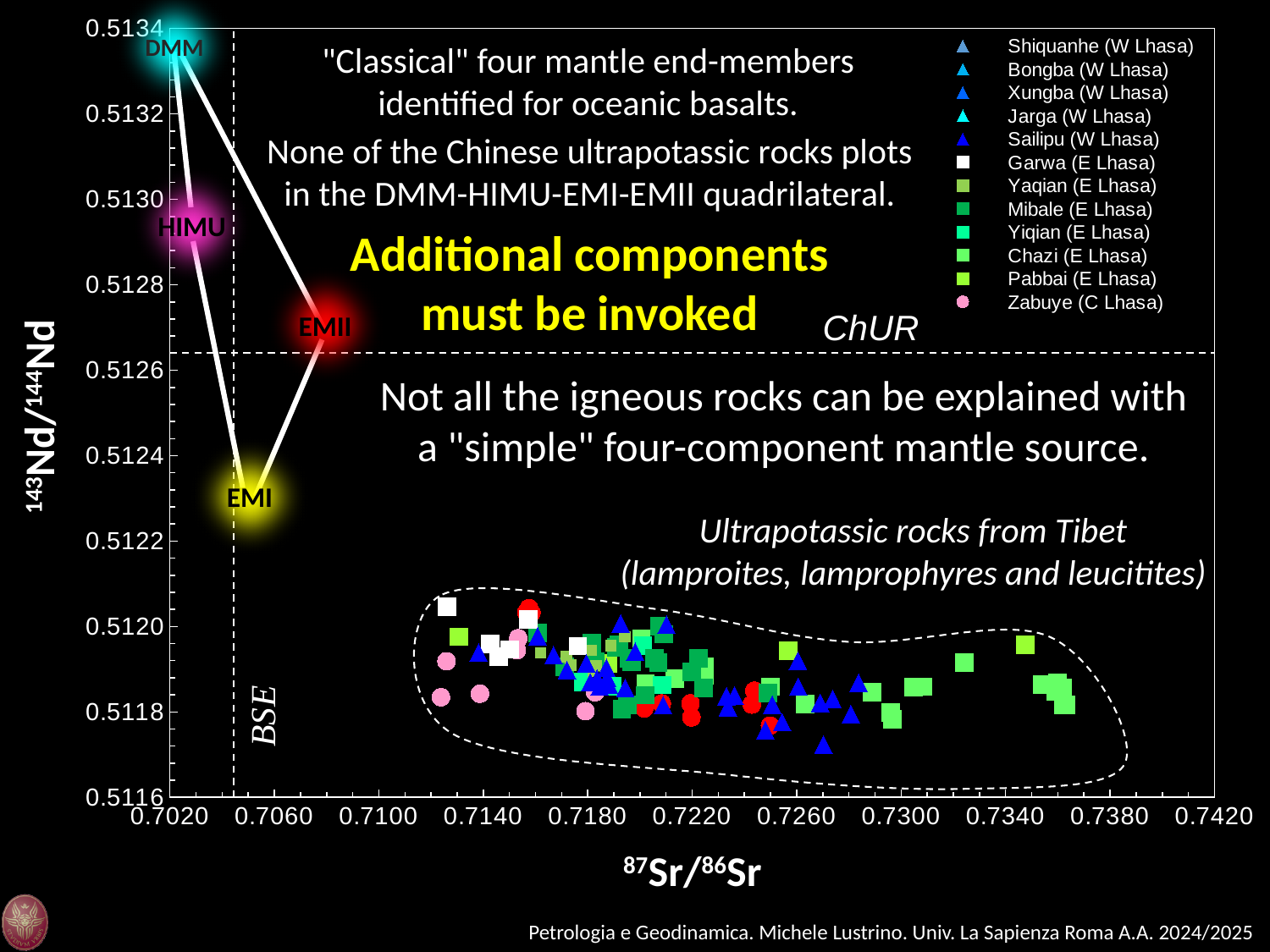
Which has a higher 143Nd/144Nd value, DMM or EMI? DMM Is the 143Nd/144Nd value of EMI greater or less than 0.5124? less Are the 143Nd/144Nd values of the Tibetan ultrapotassic rocks greater or less than 0.5122? less Which mantle end-member has the lowest 143Nd/144Nd value? EMI How many 'classical' mantle end-members are plotted on the chart? 4 Is the 143Nd/144Nd value of DMM greater or less than 0.5132? greater Which mantle end-member has the highest 143Nd/144Nd value? DMM What is the label of the x axis? 87Sr/86Sr What kind of chart is shown on the slide? scatter plot Which legend entry is plotted with a circle symbol? Zabuye (C Lhasa) Which has a higher 87Sr/86Sr value, EMII or DMM? EMII How many sample localities does the legend list? 12